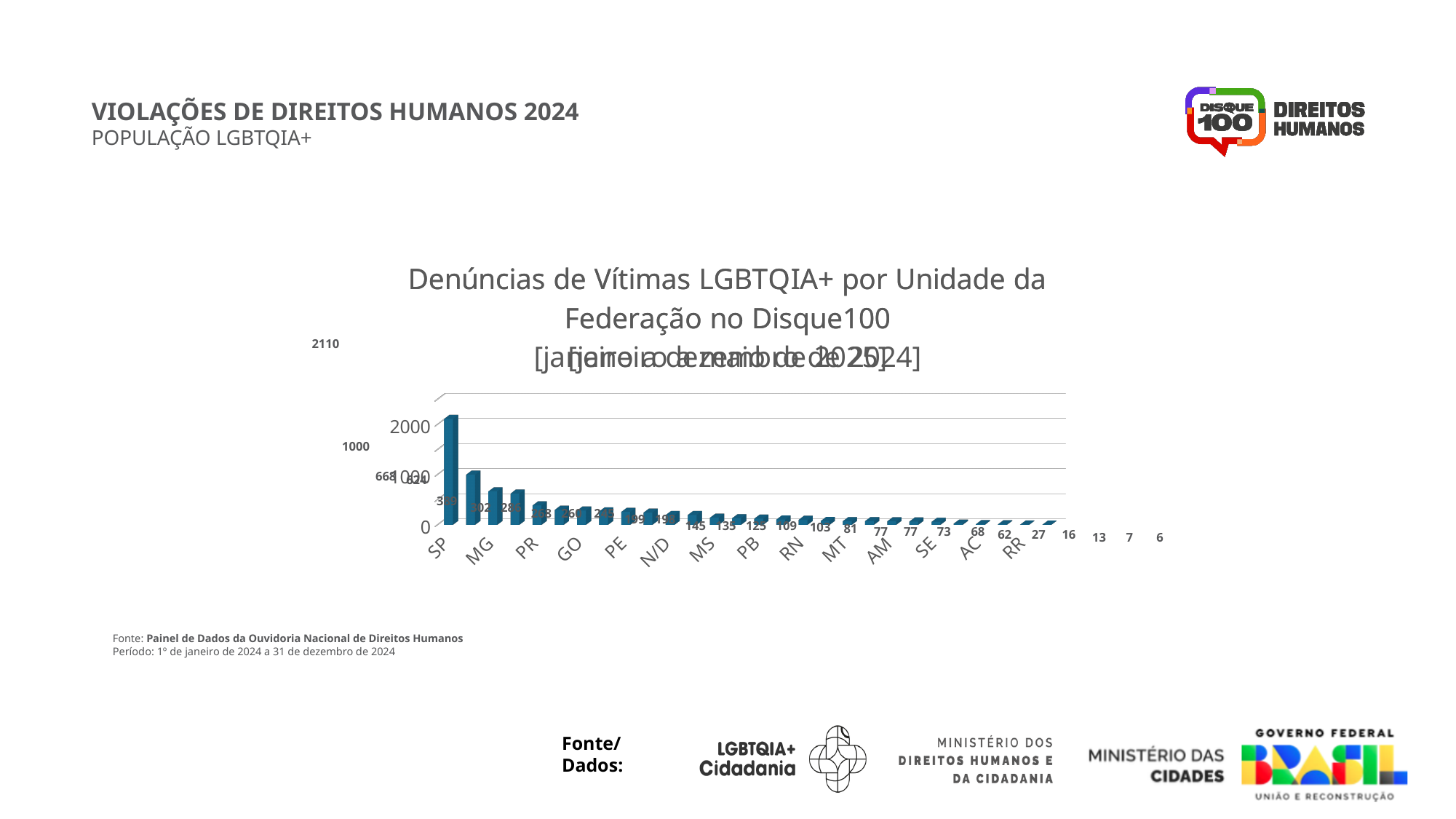
What kind of chart is shown on the slide? bar chart Which unit of the federation has the highest number of complaints in the chart? SP Is the value for PR greater or less than 1000? less What is the value shown for SP? 2110 What is the smallest data label printed on the chart? 6 Is the value for SP greater or less than 2000? greater What is the highest tick value shown on the vertical axis? 2000 Do the values rise or fall moving from left to right along the x axis? fall Which has a larger value, GO or RR? GO Which has a larger value, SP or PR? SP What is the source of the data cited below the chart? Painel de Dados da Ouvidoria Nacional de Direitos Humanos